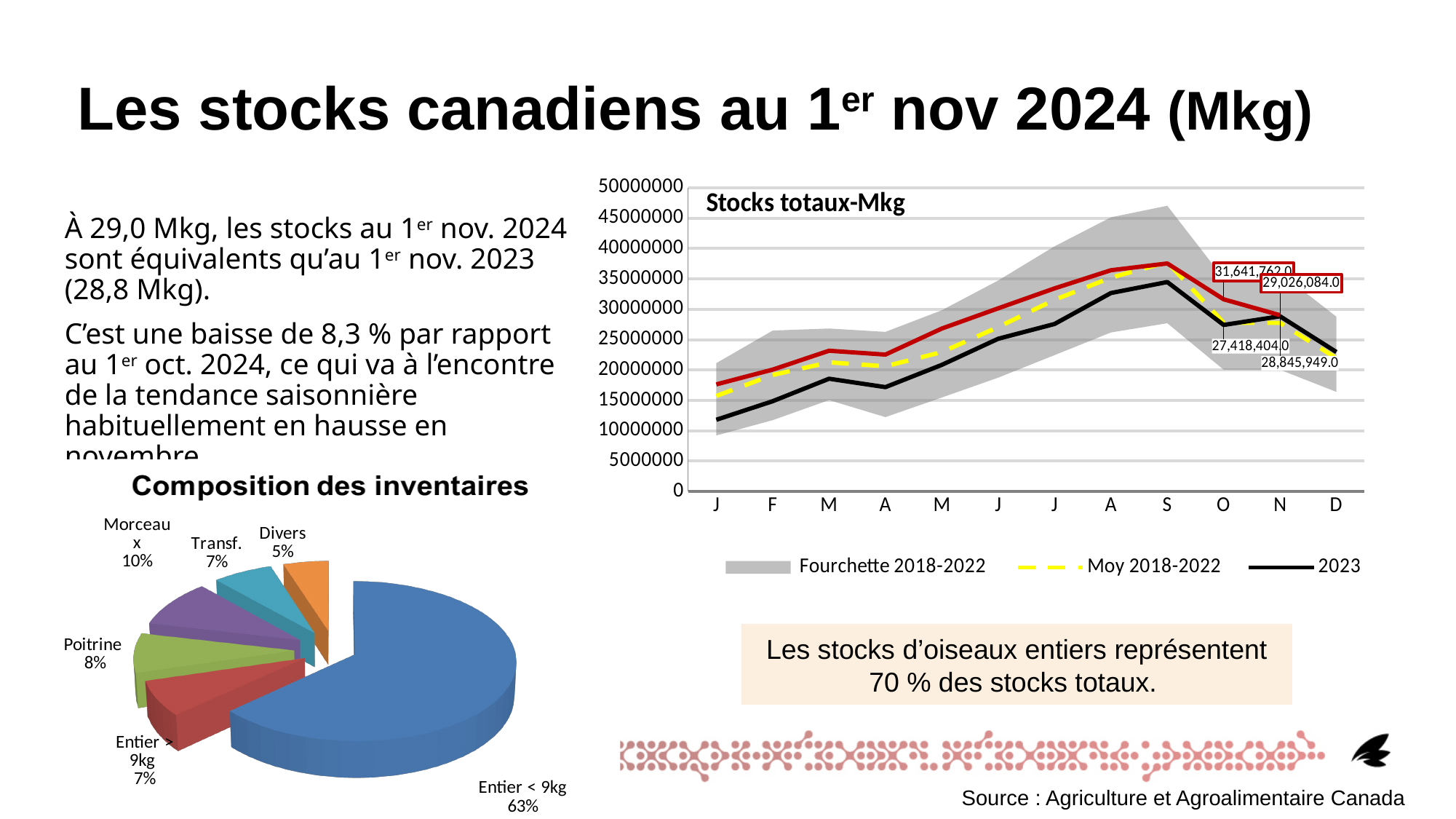
How many series does the legend of the chart 'Stocks totaux-Mkg' list? 3 In the pie chart 'Composition des inventaires', which is larger: 'Poitrine' or 'Transf.'? Poitrine How many points are on the x axis of the chart 'Stocks totaux-Mkg'? 12 In the chart 'Stocks totaux-Mkg', what is the labelled value of the 2023 series in November (N)? 28,845,949.0 In the pie chart 'Composition des inventaires', which category has the smallest slice? Divers In the pie chart 'Composition des inventaires', which category has the largest slice? Entier < 9kg What kind of chart is 'Stocks totaux-Mkg'? combination area and line chart (lines over a shaded range band) In the pie chart 'Composition des inventaires', what is the difference between 'Entier < 9kg' and 'Morceaux'? 53% In the pie chart 'Composition des inventaires', what is the value for 'Morceaux'? 10% In the chart 'Stocks totaux-Mkg', is the 2023 value in January (J) greater or less than 15000000? less How many slices does the pie chart 'Composition des inventaires' have? 6 In the pie chart 'Composition des inventaires', what share does 'Entier < 9kg' represent? 63%